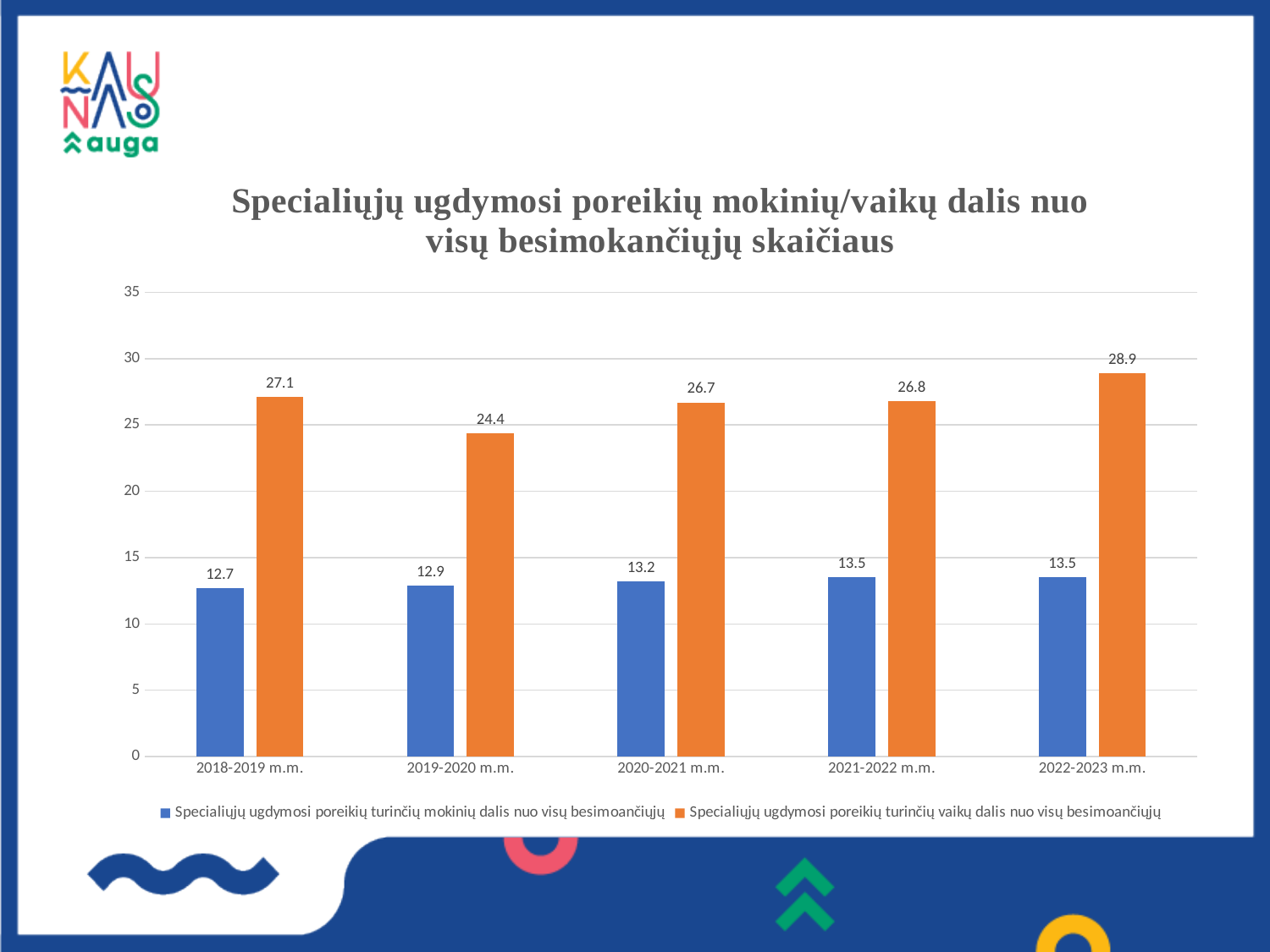
Which is larger in 2021-2022 m.m.: the 'mokinių' series or the 'vaikų' series? Specialiųjų ugdymosi poreikių turinčių vaikų dalis nuo visų besimoančiųjų In which school year is the value for 'Specialiųjų ugdymosi poreikių turinčių vaikų dalis nuo visų besimoančiųjų' lowest? 2019-2020 m.m. Does the value for 'Specialiųjų ugdymosi poreikių turinčių mokinių dalis nuo visų besimoančiųjų' rise or fall from 2018-2019 m.m. to 2022-2023 m.m.? Rise In which school year is the value for 'Specialiųjų ugdymosi poreikių turinčių mokinių dalis nuo visų besimoančiųjų' lowest? 2018-2019 m.m. What is the difference between the two series' values in 2020-2021 m.m.? 13.5 In which school year is the value for 'Specialiųjų ugdymosi poreikių turinčių vaikų dalis nuo visų besimoančiųjų' highest? 2022-2023 m.m. How many school years are shown on the x axis? 5 What is the value for 'Specialiųjų ugdymosi poreikių turinčių vaikų dalis nuo visų besimoančiųjų' in 2019-2020 m.m.? 24.4 What is the value for 'Specialiųjų ugdymosi poreikių turinčių mokinių dalis nuo visų besimoančiųjų' in 2018-2019 m.m.? 12.7 How many series does the legend list? 2 What is the value for 'Specialiųjų ugdymosi poreikių turinčių vaikų dalis nuo visų besimoančiųjų' in 2022-2023 m.m.? 28.9 What kind of chart is shown on the slide? Bar chart